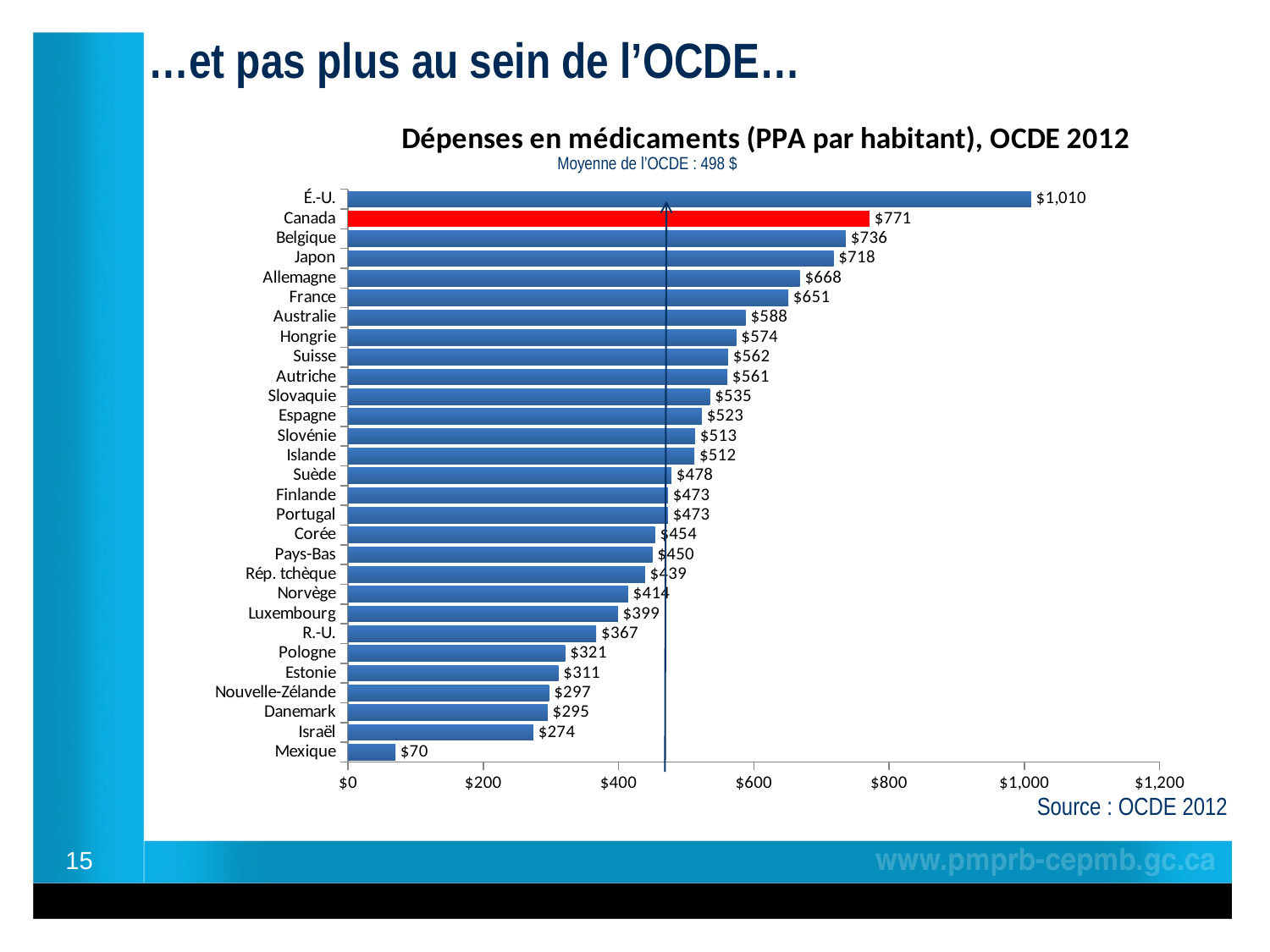
What is the value for Mexique? $70 How many countries are shown in the chart? 29 Is the value for Australie greater or less than $600? less What is the difference between the values for É.-U. and Canada? $239 Which country has the lowest value? Mexique What is the OECD average (Moyenne de l'OCDE) stated under the chart title? 498 $ Which country has the highest value? É.-U. What is the value for Canada? $771 Which is larger, the value for Belgique or the value for Allemagne? Belgique What is the difference between the values for France and R.-U.? $284 What kind of chart is shown on the slide? bar chart What is the value for Japon? $718